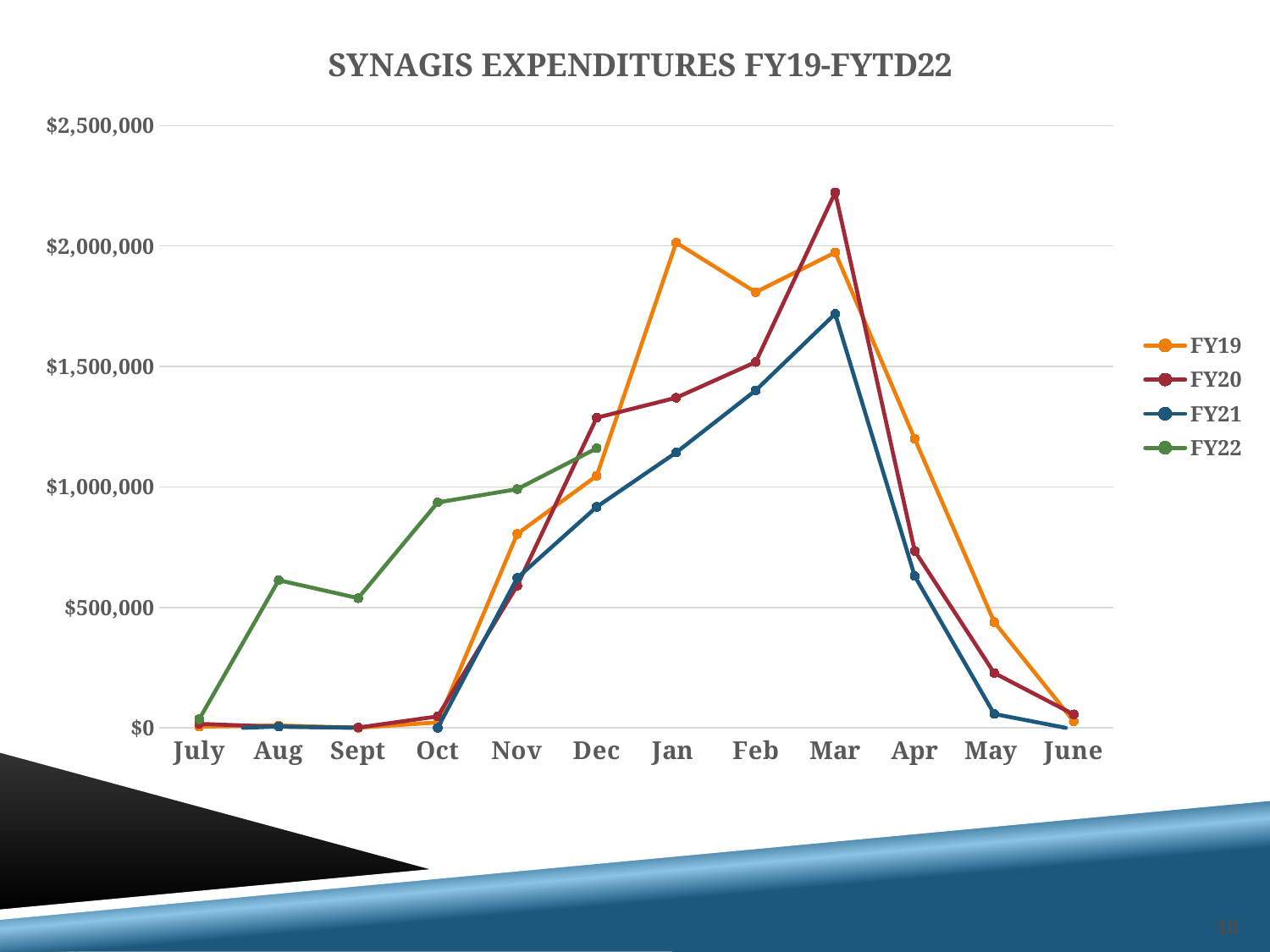
Is the FY22 value for Aug greater or less than $500,000? greater How many months are shown along the x axis? 12 Which series has the lowest value in Mar? FY21 Is the FY19 value for Apr greater or less than $1,000,000? greater Is the FY20 value for Mar greater or less than $2,000,000? greater What type of chart is shown on the slide? line chart Does the FY19 series rise or fall from Mar to June? fall In Dec, which series has the larger value, FY20 or FY21? FY20 How many series does the legend list? 4 In Oct, which series has the larger value, FY22 or FY19? FY22 In which month does the FY20 series reach its highest value? Mar Which series reaches the highest peak value on the chart? FY20